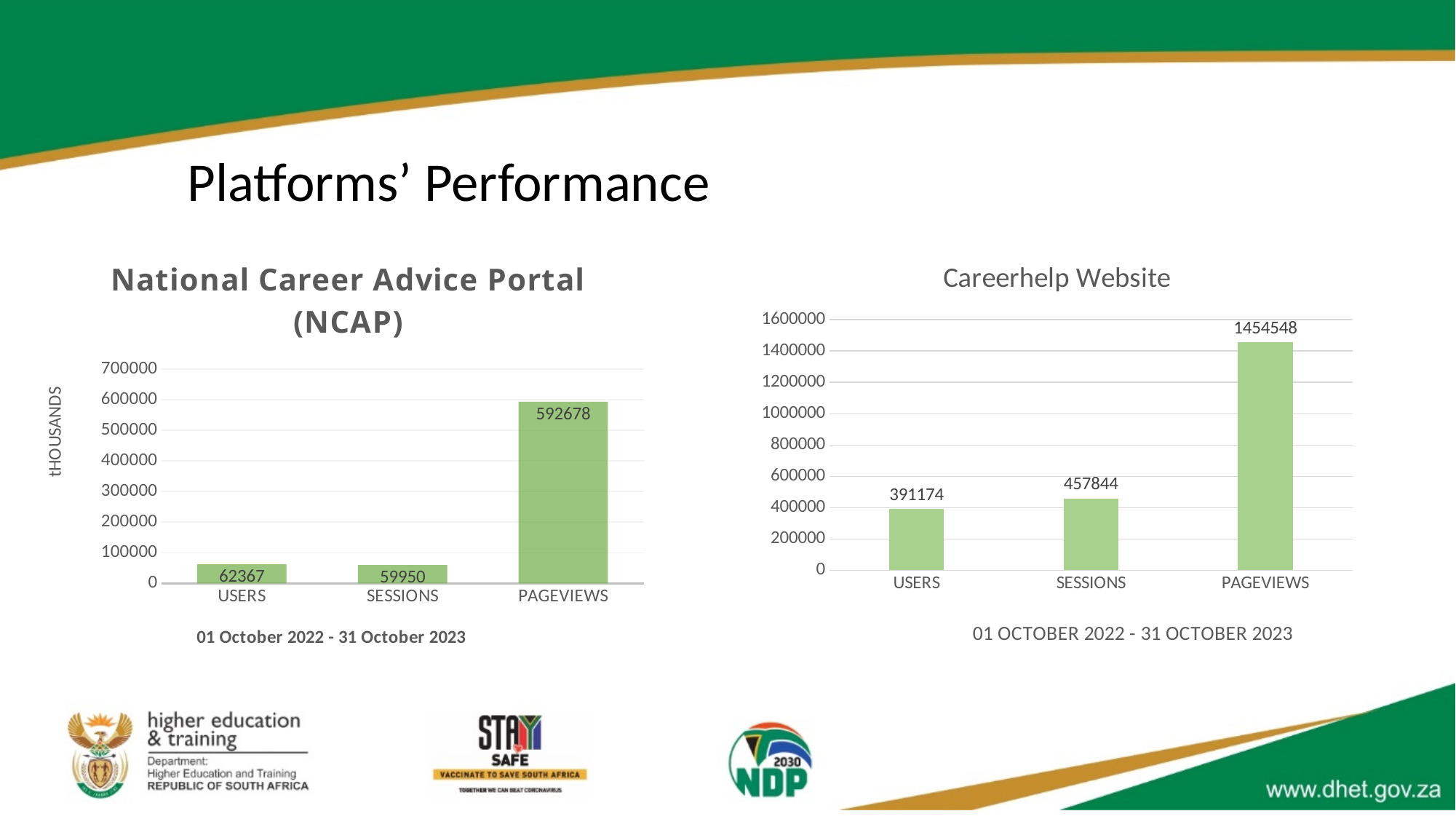
How many categories are shown in the Careerhelp Website chart? 3 In the National Career Advice Portal (NCAP) chart, what is the difference between PAGEVIEWS and USERS? 530311 In the Careerhelp Website chart, which is larger, USERS or SESSIONS? SESSIONS In the Careerhelp Website chart, which category has the highest value? PAGEVIEWS In the Careerhelp Website chart, what is the value for SESSIONS? 457844 In the National Career Advice Portal (NCAP) chart, which category has the lowest value? SESSIONS What period is shown beneath the Careerhelp Website chart? 01 OCTOBER 2022 - 31 OCTOBER 2023 In the National Career Advice Portal (NCAP) chart, what is the value for PAGEVIEWS? 592678 In the National Career Advice Portal (NCAP) chart, what is the value for USERS? 62367 In the Careerhelp Website chart, what is the difference between SESSIONS and USERS? 66670 What kind of chart is the National Career Advice Portal (NCAP) chart? Bar chart In the Careerhelp Website chart, what is the value for PAGEVIEWS? 1454548